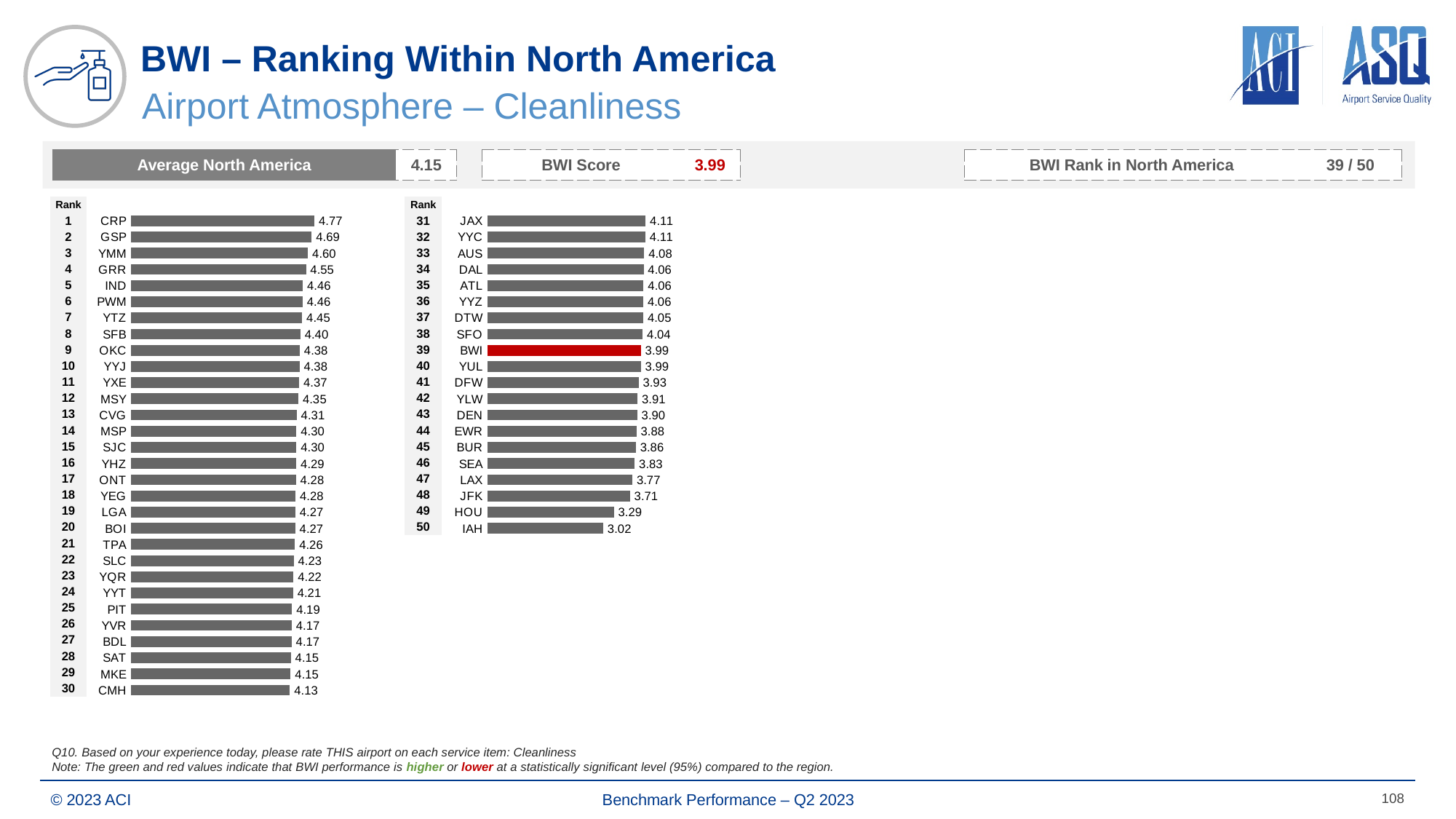
In the left-hand chart (ranks 1–30), which airport has the highest value? CRP How many airports are plotted in the right-hand chart (ranks 31–50)? 20 How many airports are plotted in the left-hand chart (ranks 1–30)? 30 What kind of chart is used to show the airport rankings on this slide? Bar chart In the right-hand chart (ranks 31–50), which airport's bar is coloured red? BWI In the right-hand chart (ranks 31–50), which airport has the lowest value? IAH In the right-hand chart (ranks 31–50), what is the value shown for BWI? 3.99 In the right-hand chart (ranks 31–50), what is the value shown for SFO? 4.04 In the left-hand chart (ranks 1–30), what is the difference between the values for CRP and GSP? 0.08 In the right-hand chart (ranks 31–50), what is the difference between the values for HOU and IAH? 0.27 In the left-hand chart (ranks 1–30), what is the value shown for MSY? 4.35 In the right-hand chart (ranks 31–50), which has the larger value, LAX or JFK? LAX